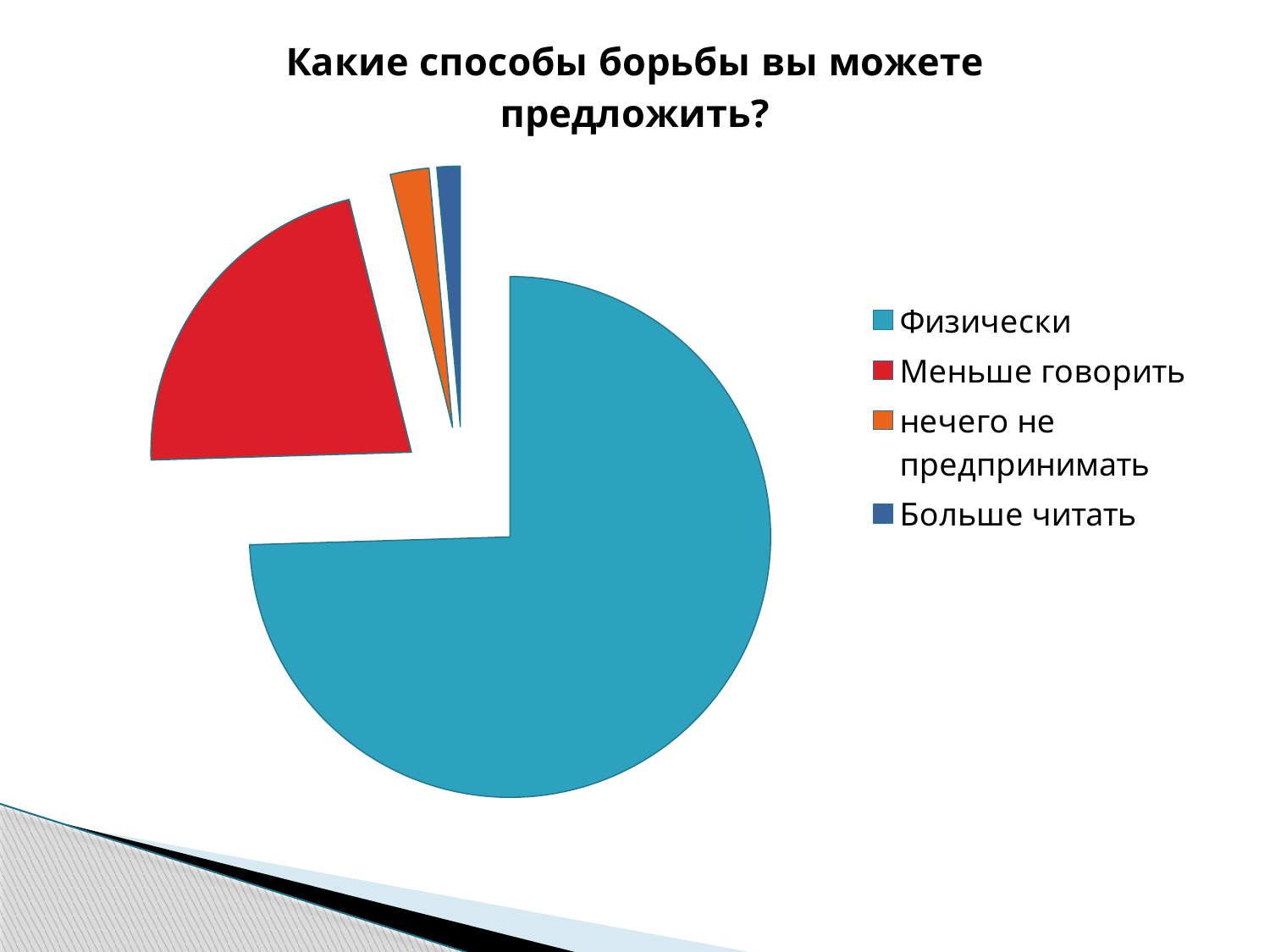
Which slice is larger: Меньше говорить or нечего не предпринимать? Меньше говорить Which slice is larger: нечего не предпринимать or Больше читать? нечего не предпринимать What is the title of the chart? Какие способы борьбы вы можете предложить? Which slice is larger: Физически or Меньше говорить? Физически What kind of chart is shown on the slide? pie chart Which category has the largest slice of the pie chart? Физически What colour is the slice for Меньше говорить? red How many categories does the pie chart have? 4 Which category has the smallest slice of the pie chart? Больше читать